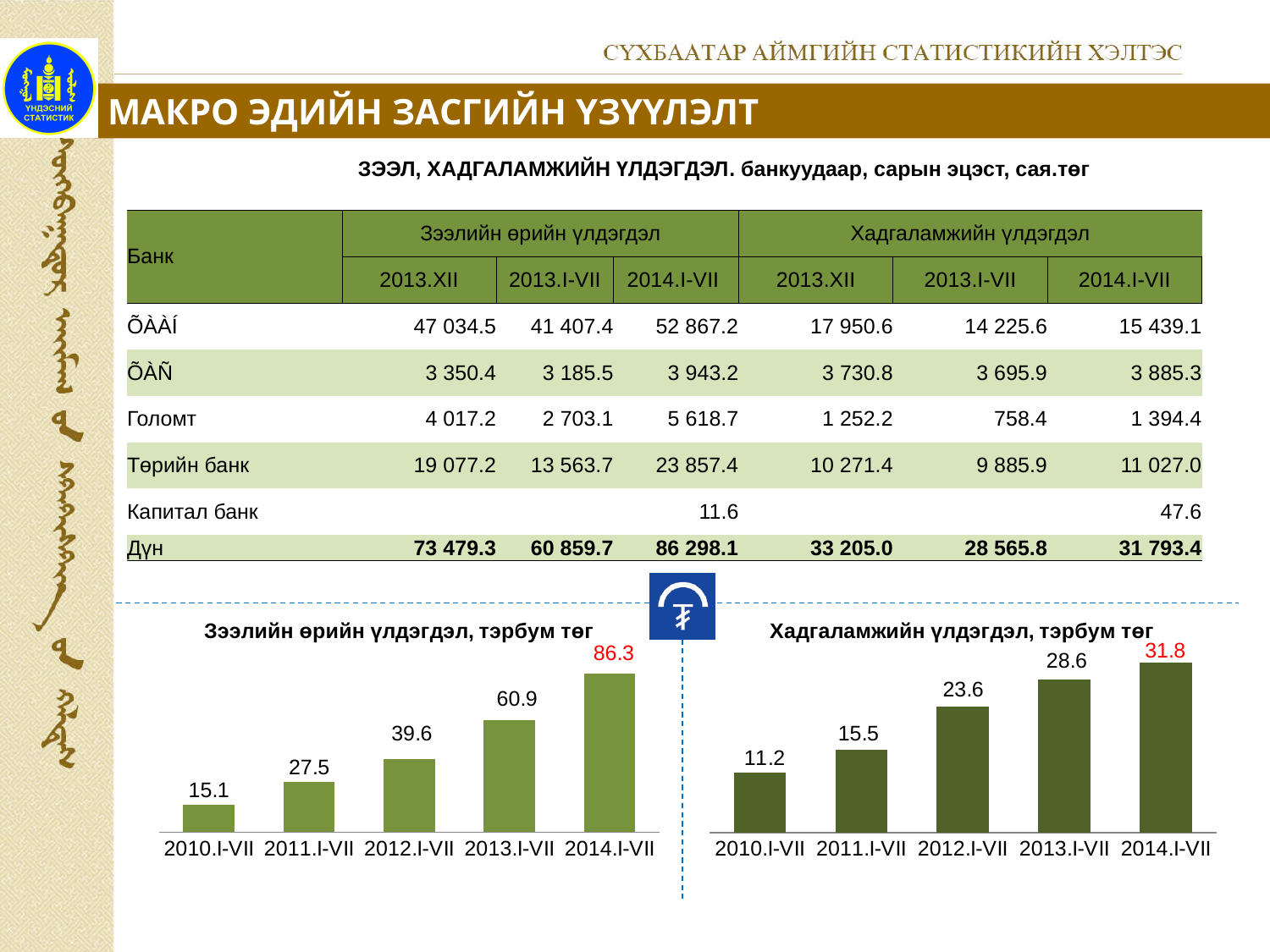
In the chart titled 'Хадгаламжийн үлдэгдэл, тэрбум төг', what is the difference between the values for 2013.I-VII and 2012.I-VII? 5.0 In the chart titled 'Хадгаламжийн үлдэгдэл, тэрбум төг', what is the value for 2012.I-VII? 23.6 In the chart titled 'Зээлийн өрийн үлдэгдэл, тэрбум төг', which period has the lowest value? 2010.I-VII In the chart titled 'Зээлийн өрийн үлдэгдэл, тэрбум төг', what is the value for 2014.I-VII? 86.3 In the chart titled 'Хадгаламжийн үлдэгдэл, тэрбум төг', do the values rise or fall from 2010.I-VII to 2014.I-VII? Rise In the chart titled 'Хадгаламжийн үлдэгдэл, тэрбум төг', which period has the highest value? 2014.I-VII How many periods are shown in the chart titled 'Хадгаламжийн үлдэгдэл, тэрбум төг'? 5 In the chart titled 'Хадгаламжийн үлдэгдэл, тэрбум төг', what is the value for 2010.I-VII? 11.2 In the chart titled 'Зээлийн өрийн үлдэгдэл, тэрбум төг', what is the value for 2011.I-VII? 27.5 What kind of chart is the chart titled 'Зээлийн өрийн үлдэгдэл, тэрбум төг'? Bar chart In the chart titled 'Зээлийн өрийн үлдэгдэл, тэрбум төг', which is larger: the value for 2012.I-VII or 2013.I-VII? 2013.I-VII In the chart titled 'Зээлийн өрийн үлдэгдэл, тэрбум төг', what is the difference between the values for 2014.I-VII and 2013.I-VII? 25.4